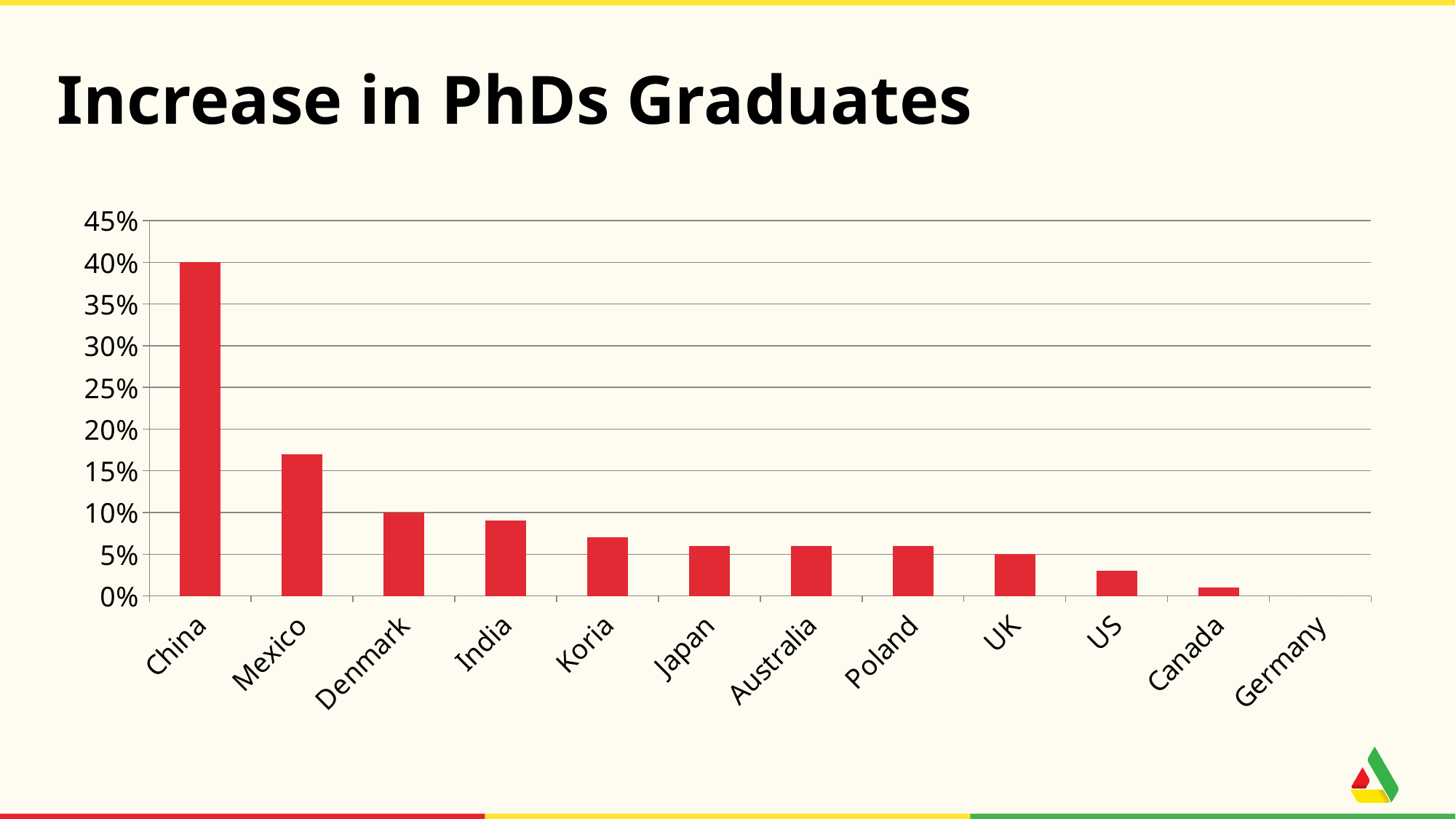
Is the value for US greater or less than 5%? less Which country has the lowest value? Germany What is the value for UK? 5% What type of chart is shown on the slide? bar chart What is the value for Denmark? 10% What is the difference between the values for China and Denmark? 30% How many countries are shown on the x axis? 12 What is the title of the chart? Increase in PhDs Graduates What is the value for China? 40% Which country has the highest value? China Is the value for Mexico greater or less than 15%? greater Which is larger, the value for Mexico or the value for India? Mexico